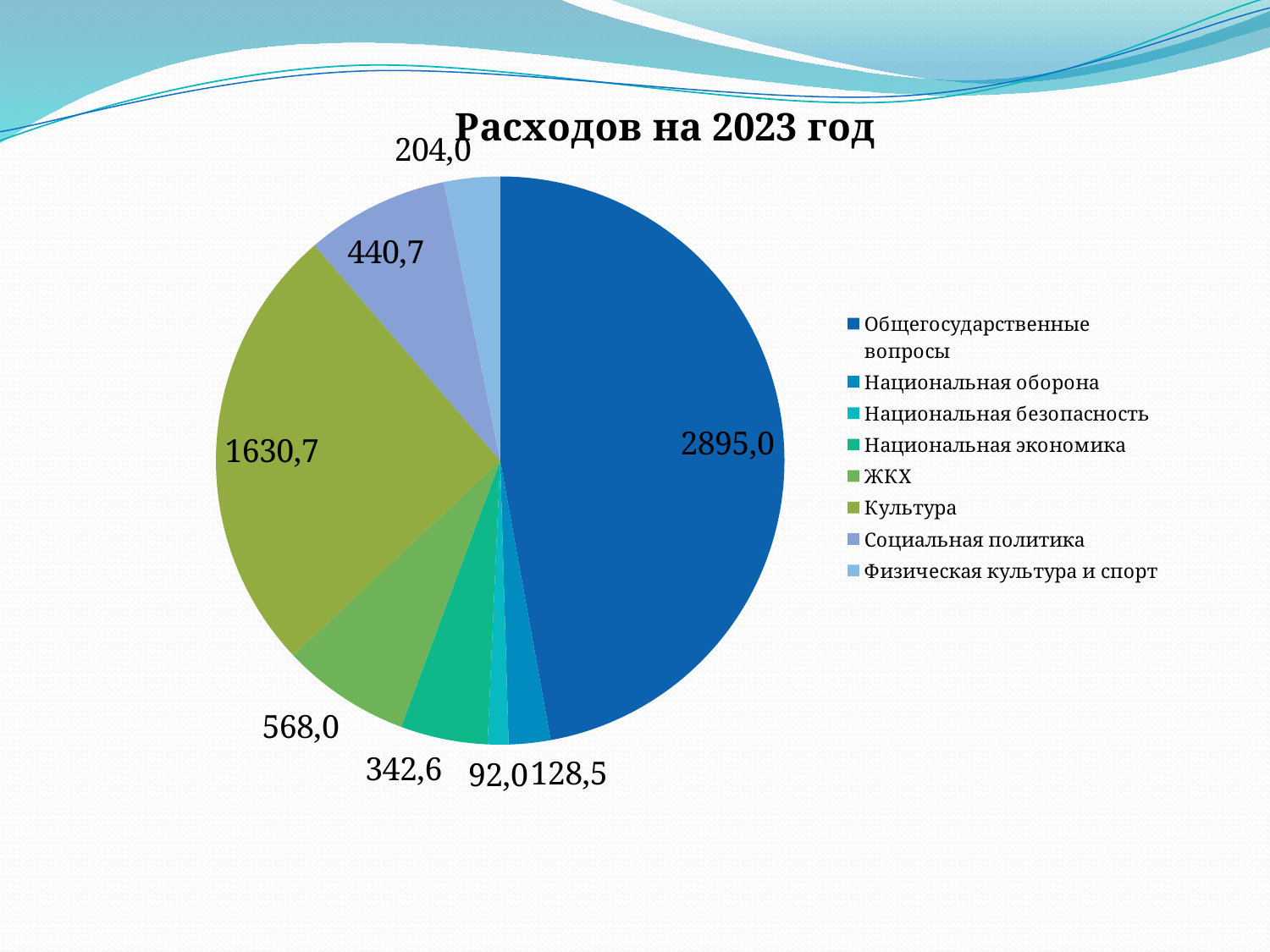
What is the value for Национальная безопасность? 92,0 What is the value for Культура? 1630,7 What is the difference between the values for ЖКХ and Национальная экономика? 225,4 What is the value for ЖКХ? 568,0 What is the title of the chart? Расходов на 2023 год What type of chart is shown on the slide? Pie chart Which category has the largest slice? Общегосударственные вопросы How many categories does the legend list? 8 What is the difference between the values for Общегосударственные вопросы and Культура? 1264,3 What is the value for Общегосударственные вопросы? 2895,0 Which category has the smallest slice? Национальная безопасность Which is larger, the value for Социальная политика or the value for Физическая культура и спорт? Социальная политика